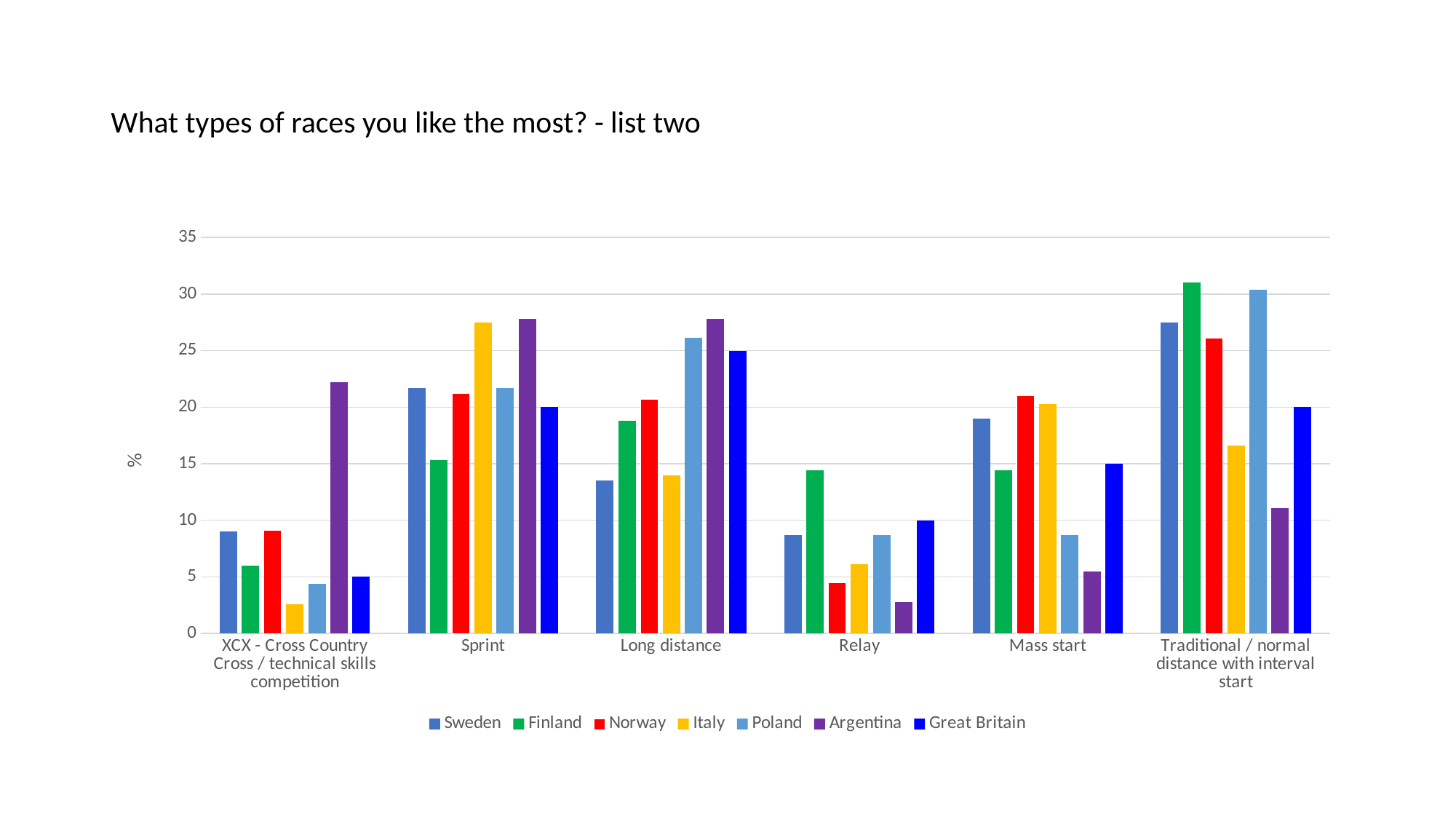
For Relay, which is larger: the value for Finland or the value for Norway? Finland Which country has the lowest value for Relay? Argentina Which country has the highest value for Long distance? Argentina Which country has the lowest value for Mass start? Argentina What kind of chart is shown on the slide? bar chart How many race types are shown along the x axis? 6 Which country has the highest value for XCX - Cross Country Cross / technical skills competition? Argentina What is the label on the vertical axis of the chart? % Is the value for Finland in Traditional / normal distance with interval start greater or less than 30? greater How many countries does the legend list? 7 Is the value for Italy in Sprint greater or less than 25? greater Is the value for Argentina in Relay greater or less than 5? less